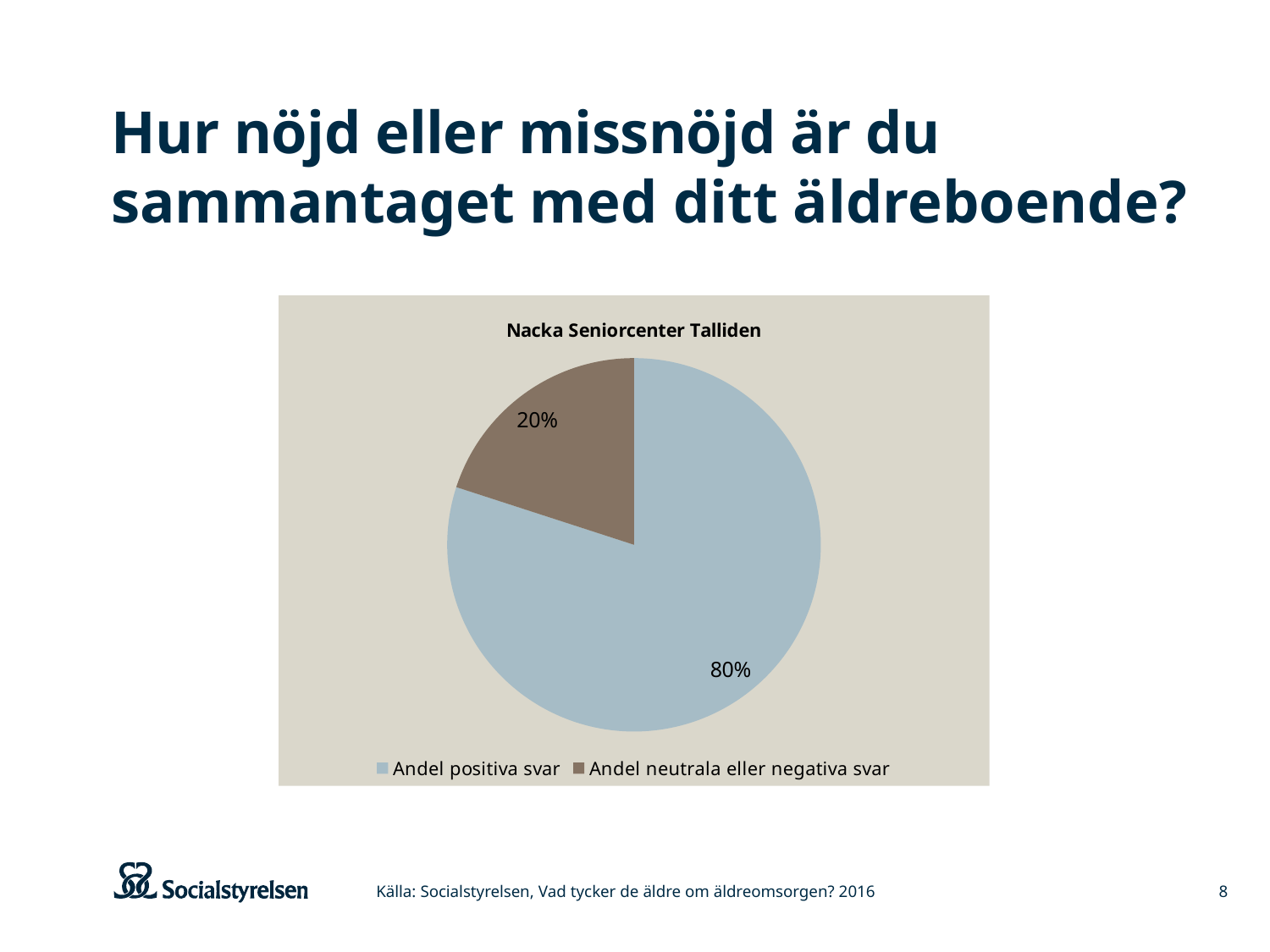
How many entries does the legend list? 2 Which slice is the smallest? Andel neutrala eller negativa svar What share of the pie is 'Andel neutrala eller negativa svar'? 20% What kind of chart is shown on the slide? pie chart How many slices does the pie chart have? 2 What is the chart's title? Nacka Seniorcenter Talliden What is the difference between the 'Andel positiva svar' and 'Andel neutrala eller negativa svar' shares? 60% Which is larger: 'Andel positiva svar' or 'Andel neutrala eller negativa svar'? Andel positiva svar What colour is the 'Andel positiva svar' slice? light blue What share of the pie is 'Andel positiva svar'? 80% Which slice is the largest? Andel positiva svar